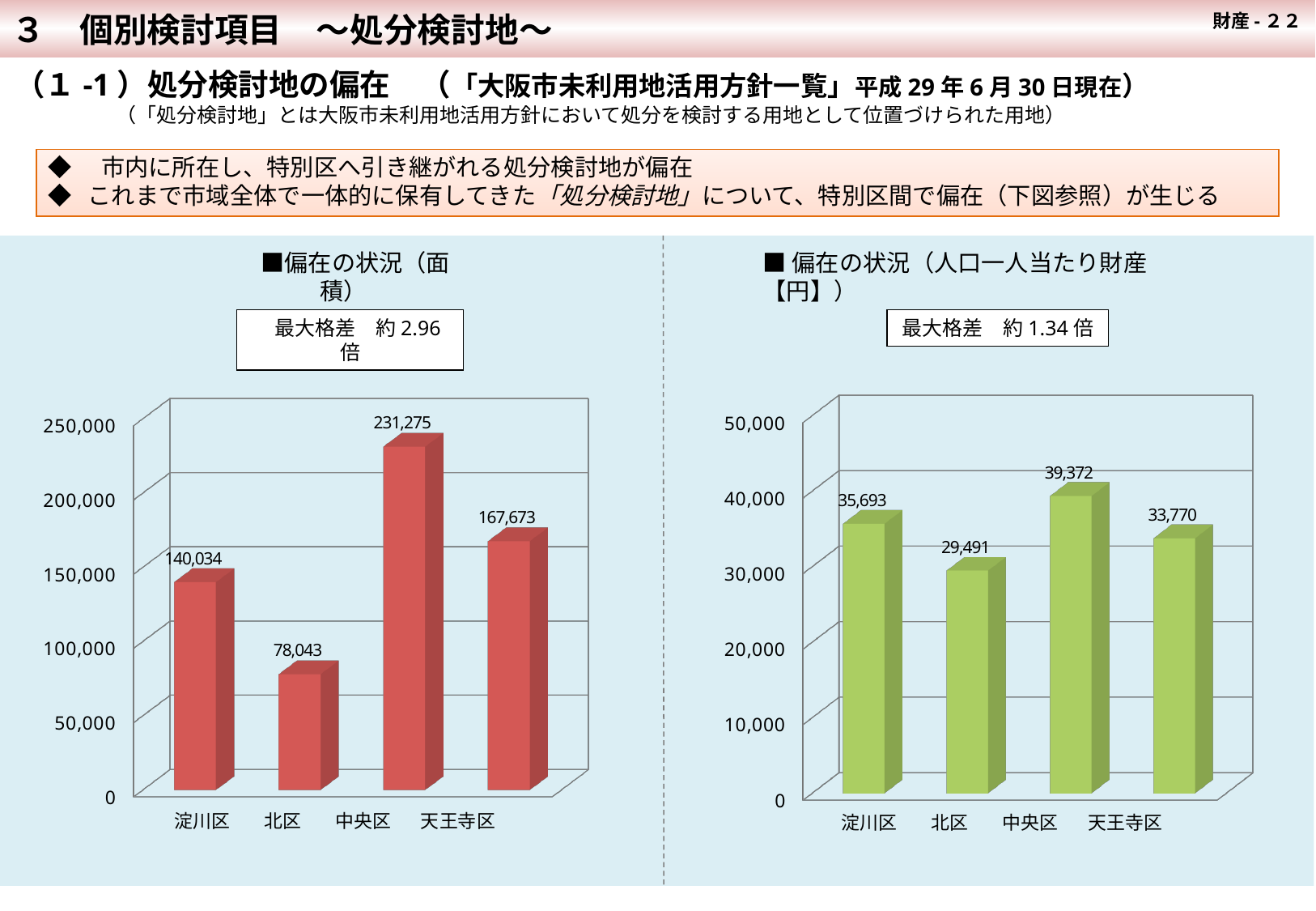
In the left chart (偏在の状況（面積）), which is larger, the value for 淀川区 or 天王寺区? 天王寺区 In the left chart (偏在の状況（面積）), what is the difference between the values for 中央区 and 北区? 153,232 In the left chart (偏在の状況（面積）), which district has the highest value? 中央区 What type of chart is the left chart (偏在の状況（面積）)? Bar chart In the right chart (偏在の状況（人口一人当たり財産【円】）), which district has the lowest value? 北区 How many districts are shown in the right chart (偏在の状況（人口一人当たり財産【円】）)? 4 In the right chart (偏在の状況（人口一人当たり財産【円】）), what is the difference between the values for 中央区 and 北区? 9,881 In the right chart (偏在の状況（人口一人当たり財産【円】）), which district has the highest value? 中央区 In the left chart (偏在の状況（面積）), what is the value for 中央区? 231,275 In the right chart (偏在の状況（人口一人当たり財産【円】）), what is the value for 天王寺区? 33,770 In the left chart (偏在の状況（面積）), what is the value for 北区? 78,043 In the left chart (偏在の状況（面積）), which district has the lowest value? 北区